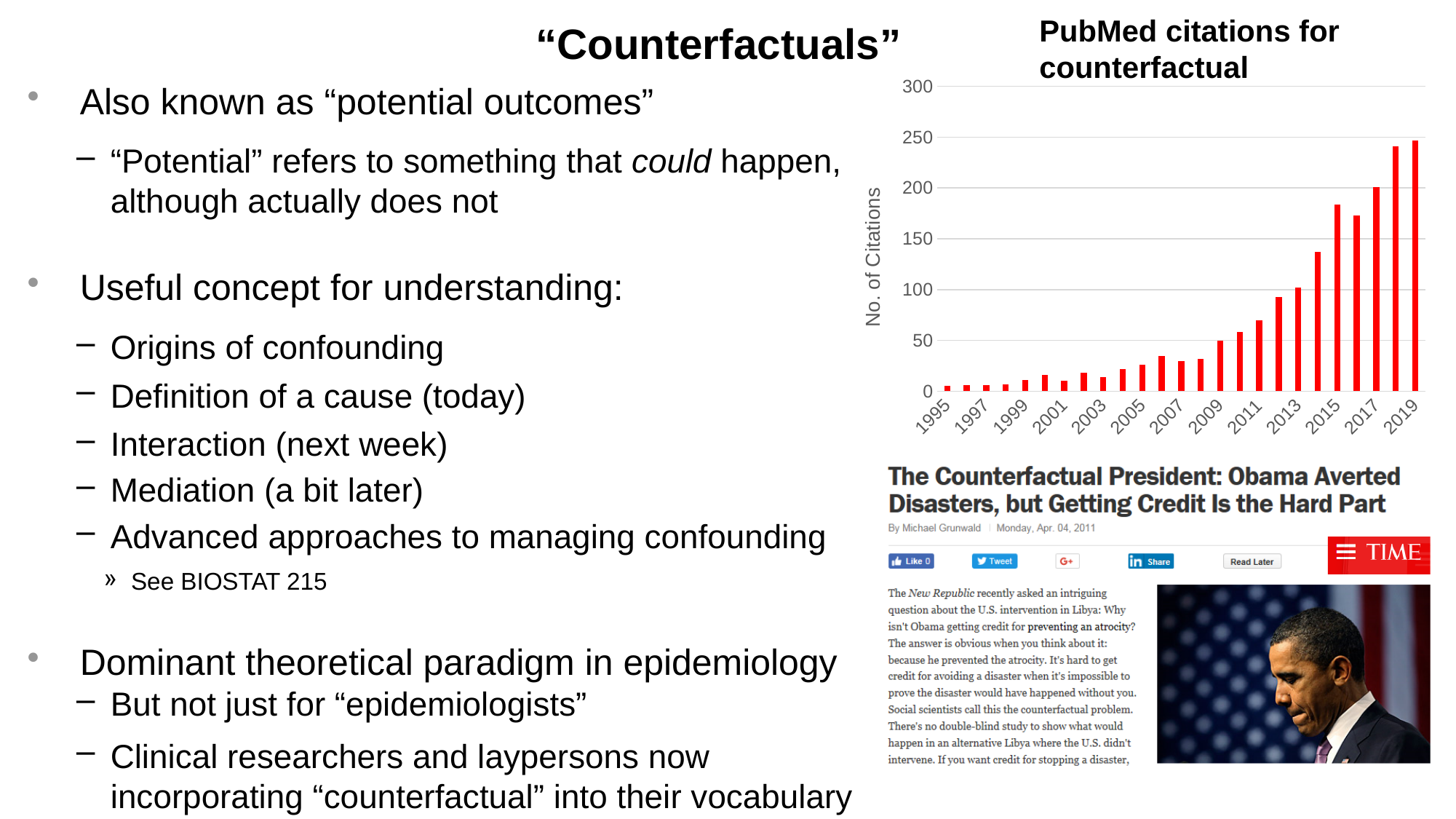
Do the citation counts generally rise or fall from 1995 to 2019? rise Which year has the highest number of citations? 2019 What is the title of the chart? PubMed citations for counterfactual Is the value for 2019 greater or less than 200? greater Is the value for 2017 greater or less than 150? greater Is the value for 2015 greater or less than 150? greater Which year has the lowest number of citations? 1995 What is the label on the y-axis of the chart? No. of Citations Which year has more citations, 2011 or 2019? 2019 What kind of chart is shown on the slide? bar chart